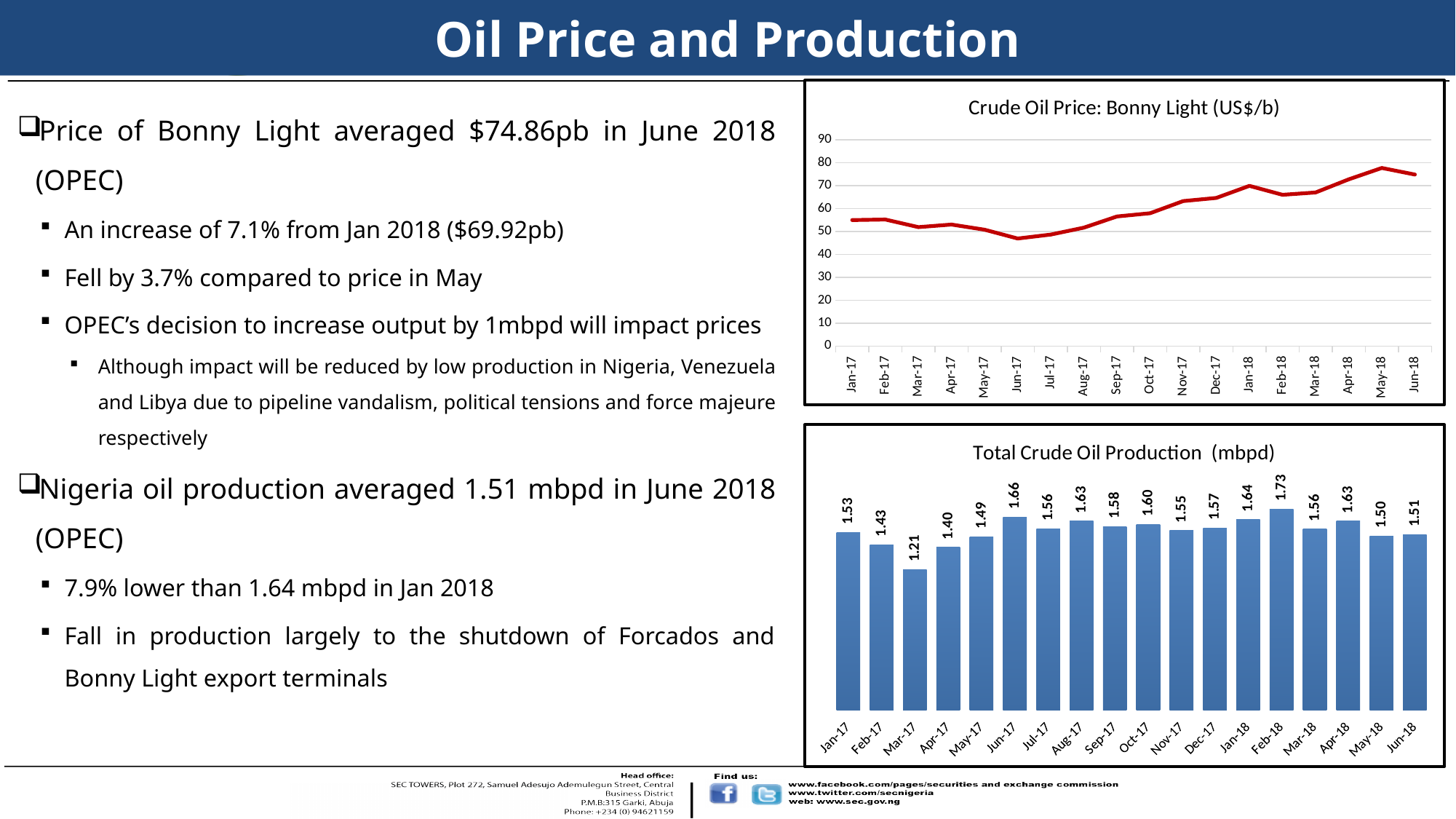
In the Total Crude Oil Production chart, which month has the highest production? Feb-18 What kind of chart is the Crude Oil Price: Bonny Light chart? Line chart In the Total Crude Oil Production chart, what was production in Feb-18? 1.73 In the Total Crude Oil Production chart, what was production in Jun-18? 1.51 What kind of chart is the Total Crude Oil Production chart? Bar chart How many months are shown in the Total Crude Oil Production chart? 18 In the Total Crude Oil Production chart, what is the difference between the Feb-18 and Mar-17 values? 0.52 In the Crude Oil Price: Bonny Light chart, is the value for May-18 greater or less than 70? greater In the Total Crude Oil Production chart, which month has the lowest production? Mar-17 In the Total Crude Oil Production chart, which is larger, the value for Jun-17 or the value for Jul-17? Jun-17 In the Crude Oil Price: Bonny Light chart, does the price generally rise or fall from Jun-17 to May-18? Rise In the Crude Oil Price: Bonny Light chart, is the value for Jun-17 greater or less than 50? less